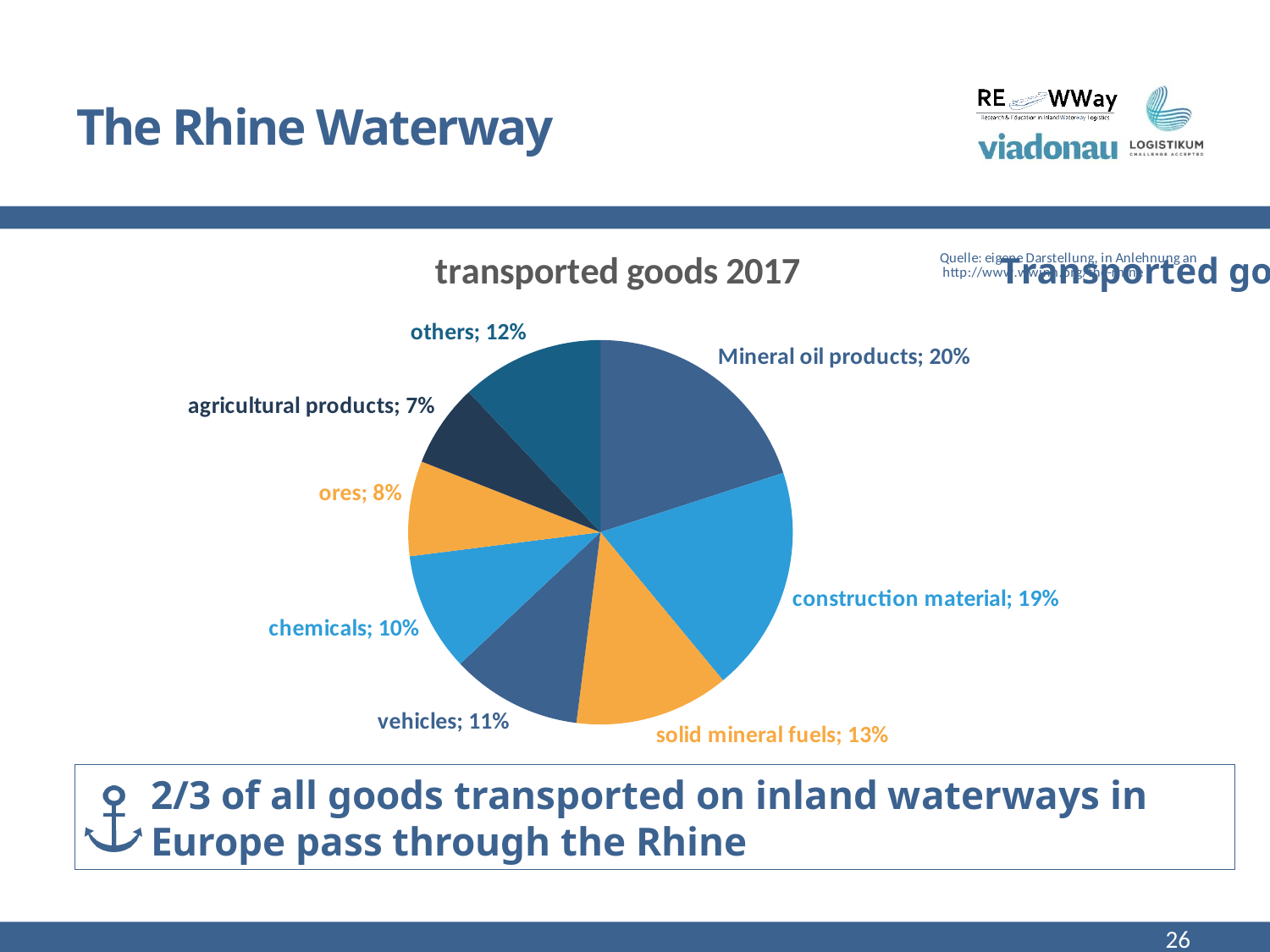
What share of transported goods in 2017 is agricultural products? 7% What share of transported goods in 2017 is construction material? 19% What is the title of the chart? transported goods 2017 Which category has the smallest share of transported goods in 2017? agricultural products Which category has the largest share of transported goods in 2017? Mineral oil products Which has a larger share, vehicles or ores? vehicles What is the difference in share between Mineral oil products and chemicals? 10% What is the combined share of ores and chemicals? 18% What share of transported goods in 2017 is Mineral oil products? 20% How many categories are shown in the pie chart? 8 What share of transported goods in 2017 is solid mineral fuels? 13% What kind of chart is shown on the slide? pie chart